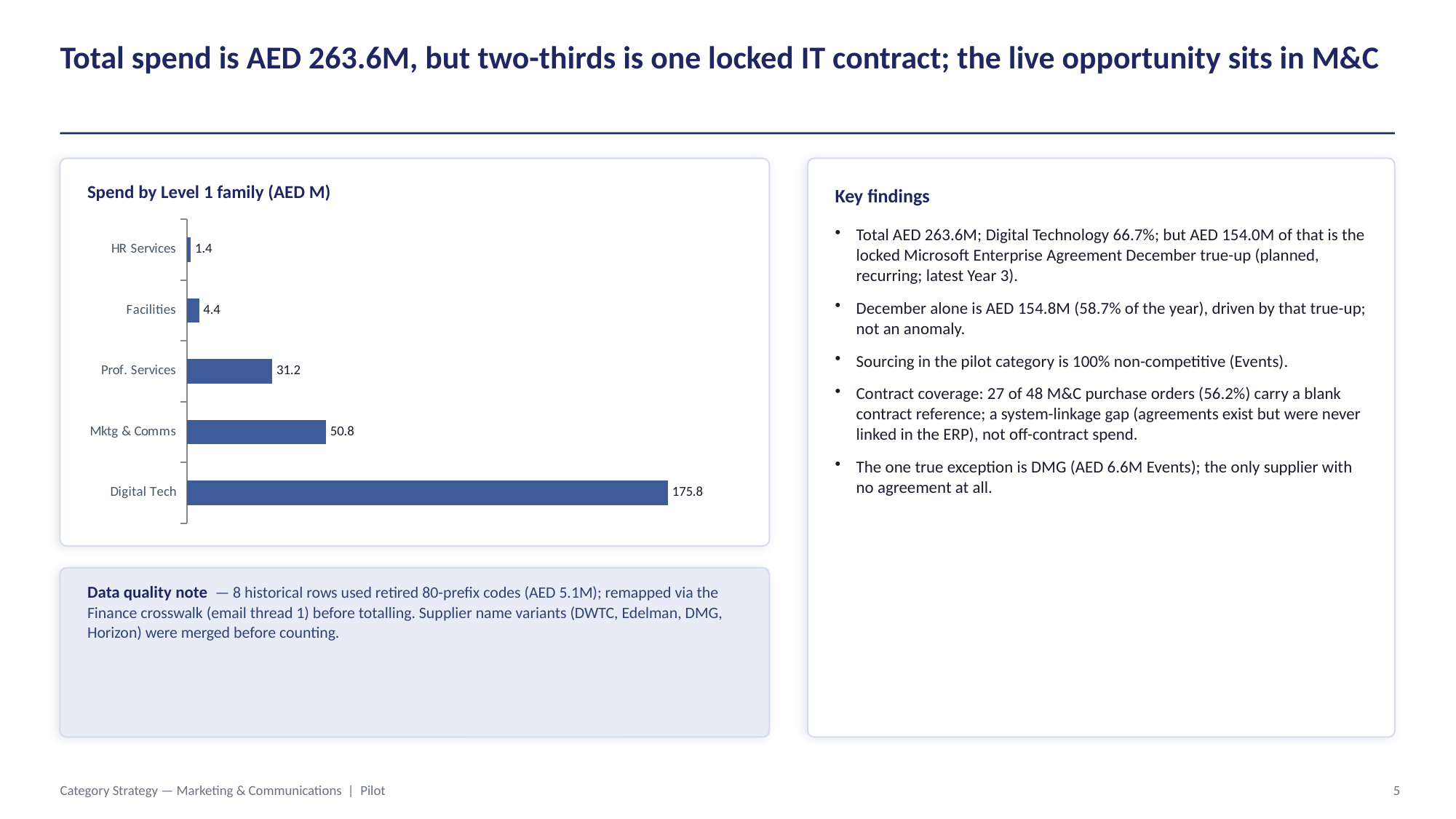
Which category has the lowest spend in the Spend by Level 1 family chart? HR Services What is the title of the chart on the slide? Spend by Level 1 family (AED M) Which category has the highest spend in the Spend by Level 1 family chart? Digital Tech What is the value for HR Services in the Spend by Level 1 family chart? 1.4 What is the value for Mktg & Comms in the Spend by Level 1 family chart? 50.8 How many categories are shown in the Spend by Level 1 family chart? 5 What is the difference between the Facilities and HR Services values in the Spend by Level 1 family chart? 3.0 What is the value for Digital Tech in the Spend by Level 1 family chart? 175.8 Which is larger in the Spend by Level 1 family chart, Prof. Services or Facilities? Prof. Services What kind of chart is the Spend by Level 1 family chart? Bar chart What is the value for Prof. Services in the Spend by Level 1 family chart? 31.2 What is the difference between the Digital Tech and Mktg & Comms values in the Spend by Level 1 family chart? 125.0